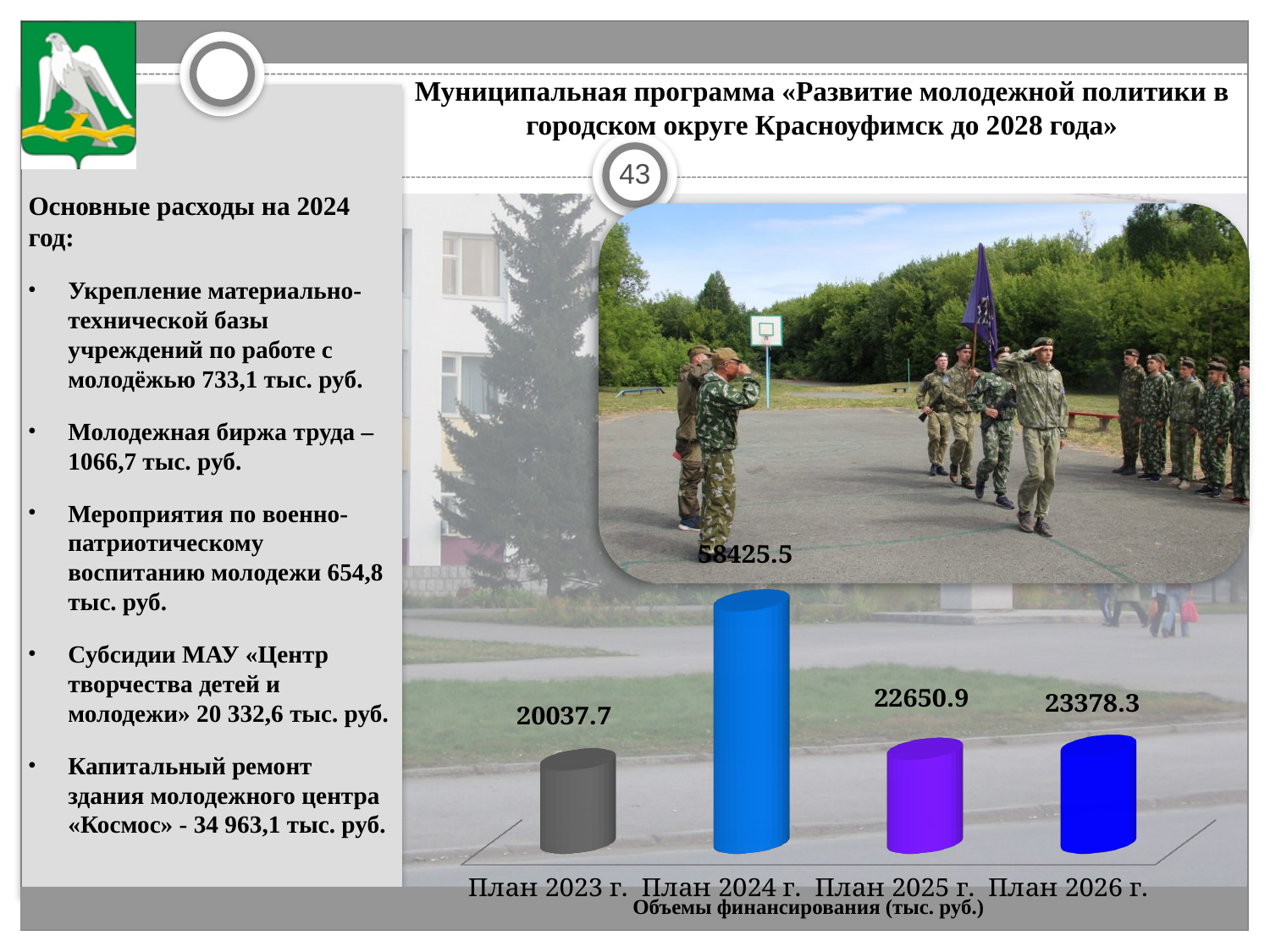
Which category has the highest value in the chart? План 2024 г. What is the value for План 2023 г. in the chart? 20037.7 What is the difference between the values for План 2026 г. and План 2025 г.? 727.4 Which is larger, the value for План 2025 г. or the value for План 2026 г.? План 2026 г. What is the value for План 2024 г. in the chart? 58425.5 How many categories are shown in the chart? 4 Which category has the lowest value in the chart? План 2023 г. What kind of chart is shown on the slide? bar chart What is the value for План 2025 г. in the chart? 22650.9 What is the difference between the values for План 2024 г. and План 2023 г.? 38387.8 What is the value for План 2026 г. in the chart? 23378.3 What unit is stated in the chart's axis caption? тыс. руб.